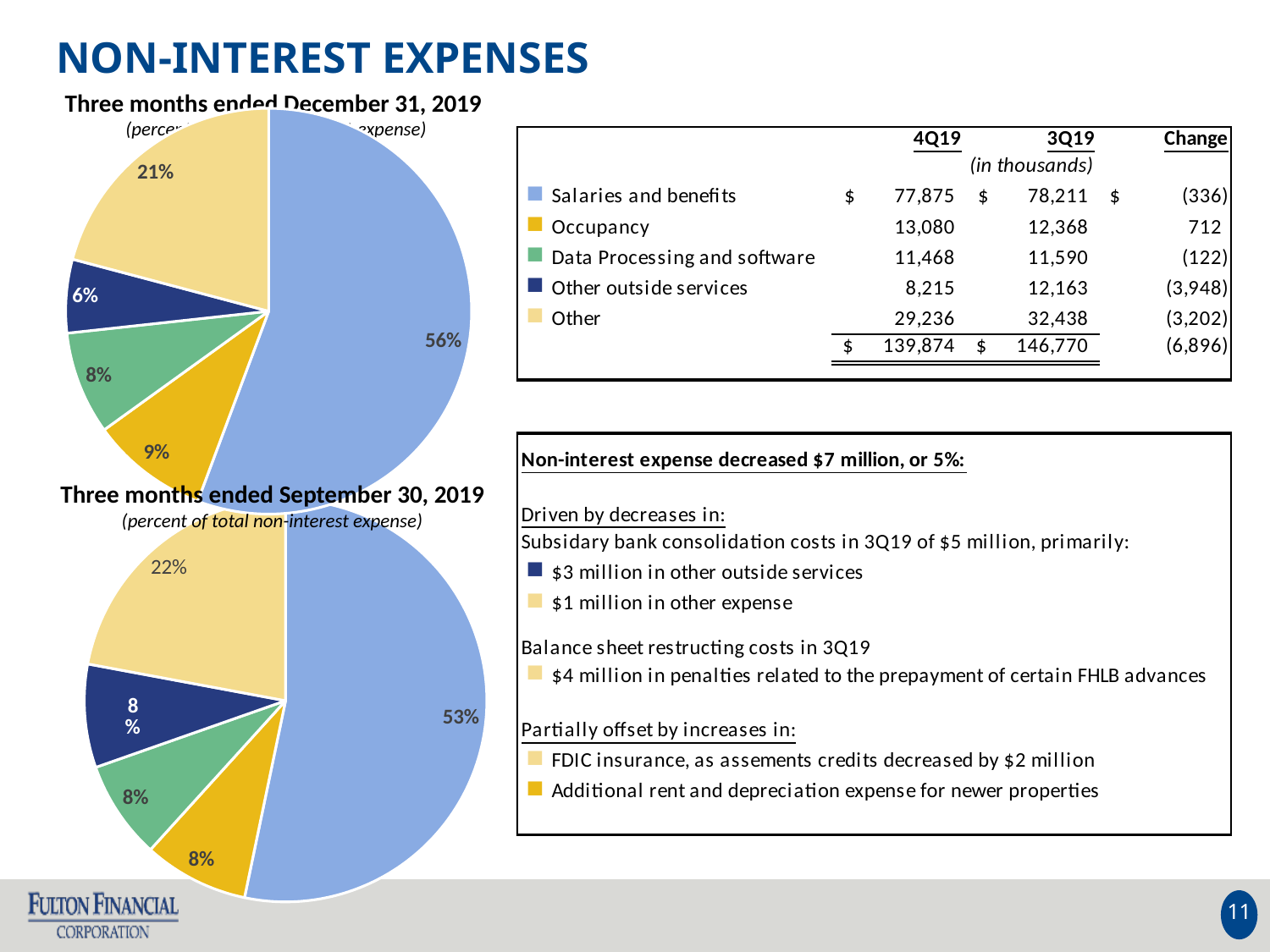
In the pie chart for the three months ended September 30, 2019, what share does the largest slice represent? 53% How many slices does the pie chart for the three months ended September 30, 2019 have? 5 In the pie chart for the three months ended December 31, 2019, which is larger: the Occupancy slice or the Data Processing and software slice? Occupancy (9%) What is the title of the lower pie chart on the slide? Three months ended September 30, 2019 In the pie chart for the three months ended December 31, 2019, what share of total non-interest expense is the largest slice? 56% In the pie chart for the three months ended December 31, 2019, what percentage is shown for the dark blue slice (Other outside services)? 6% What type of chart is used to show the breakdown of non-interest expense for the three months ended December 31, 2019? Pie chart In the pie chart for the three months ended December 31, 2019, what is the difference in percentage points between the Salaries and benefits slice and the Other slice? 35 percentage points In the pie chart for the three months ended September 30, 2019, what percentage is shown for the light yellow slice (Other)? 22% In the pie chart for the three months ended December 31, 2019, what percentage is shown for the light yellow slice (Other)? 21% In the pie chart for the three months ended December 31, 2019, which slice is the smallest? Other outside services (6%) In the pie chart for the three months ended September 30, 2019, what percentage is shown for the gold slice (Occupancy)? 8%